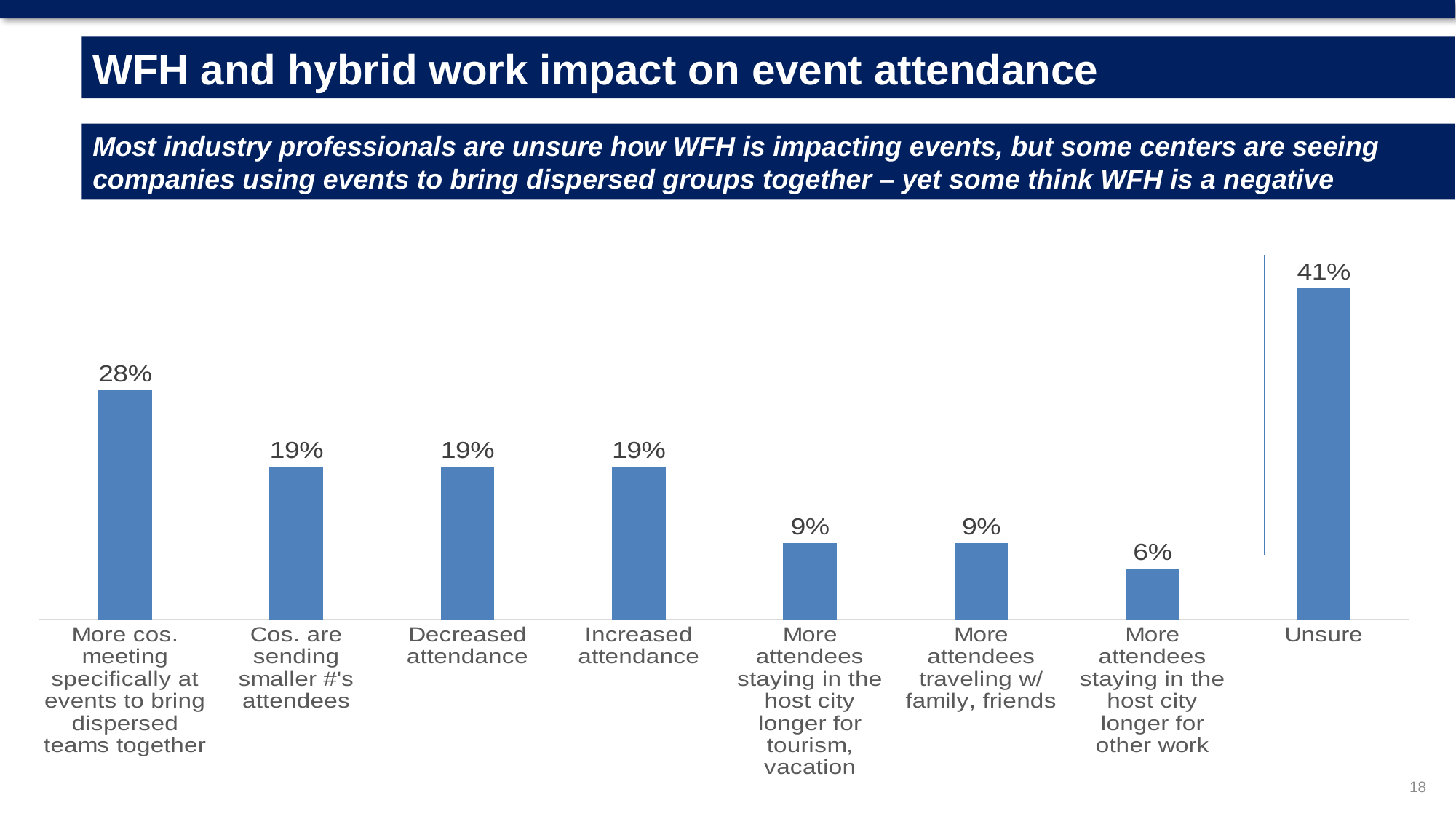
Which category has the highest value? Unsure How many categories are shown on the chart? 8 What is the title of the slide? WFH and hybrid work impact on event attendance What is the value for "More cos. meeting specifically at events to bring dispersed teams together"? 28% Which is larger: the value for "Cos. are sending smaller #'s attendees" or the value for "More attendees traveling w/ family, friends"? Cos. are sending smaller #'s attendees What is the difference between "Increased attendance" and "More attendees traveling w/ family, friends"? 10% What is the difference between the value for "Unsure" and the value for "More cos. meeting specifically at events to bring dispersed teams together"? 13% Which category has the lowest value? More attendees staying in the host city longer for other work What percentage of respondents answered "Unsure"? 41% What is the value for "Decreased attendance"? 19% What kind of chart is shown on the slide? Bar chart What is the value for "More attendees staying in the host city longer for other work"? 6%